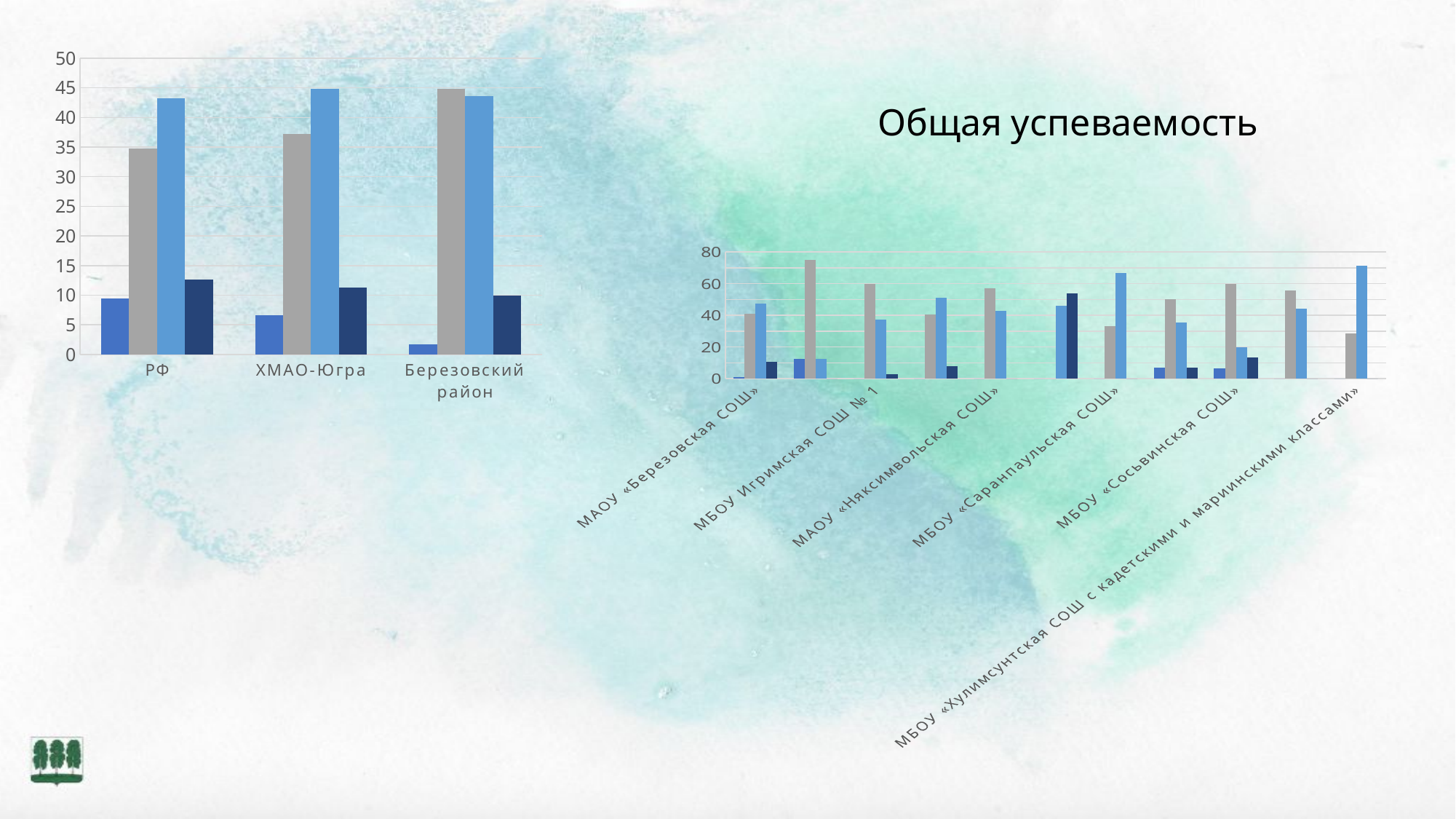
In the left chart, is the light-blue bar for РФ greater or less than 40? greater In the left chart, which category has the shortest dark-blue (first) bar? Березовский район What is the highest value shown on the y axis of the right chart? 80 In the left chart, is the first (blue) bar for Березовский район greater or less than 5? less What kind of chart is the chart on the left of the slide? bar chart In the left chart, is the gray bar for ХМАО-Югра greater or less than 30? greater In the left chart, which category has the tallest gray bar? Березовский район In the left chart, do the first (blue) bars rise or fall from РФ to Березовский район? fall How many categories are shown on the x axis of the left chart? 3 How many bars are plotted for each category in the left chart? 4 In the left chart, for РФ, which is larger: the gray bar or the light-blue bar? the light-blue bar What title is shown above the right chart? Общая успеваемость